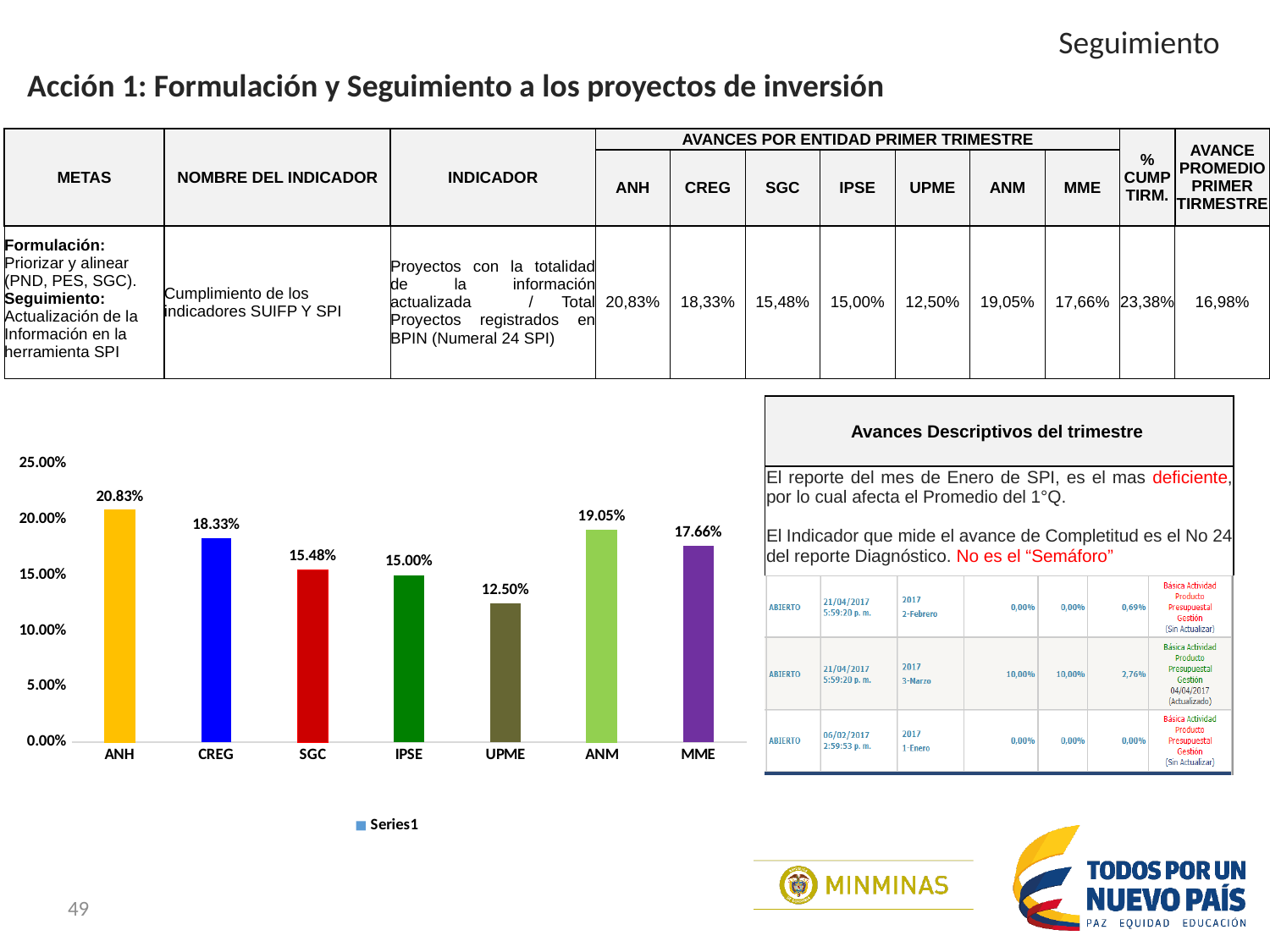
What is the difference between the values for ANH and UPME in the bar chart? 8.33% What is the value for ANM in the bar chart? 19.05% Is the value for SGC in the bar chart greater or less than 15.00%? greater Which is larger in the bar chart, the value for CREG or the value for MME? CREG Which category has the highest value in the bar chart? ANH What is the value for UPME in the bar chart? 12.50% What is the legend entry shown below the bar chart? Series1 How many categories are shown in the bar chart? 7 How many series does the legend of the bar chart list? 1 What kind of chart is shown on the slide? bar chart What is the value for ANH in the bar chart? 20.83% Which category has the lowest value in the bar chart? UPME